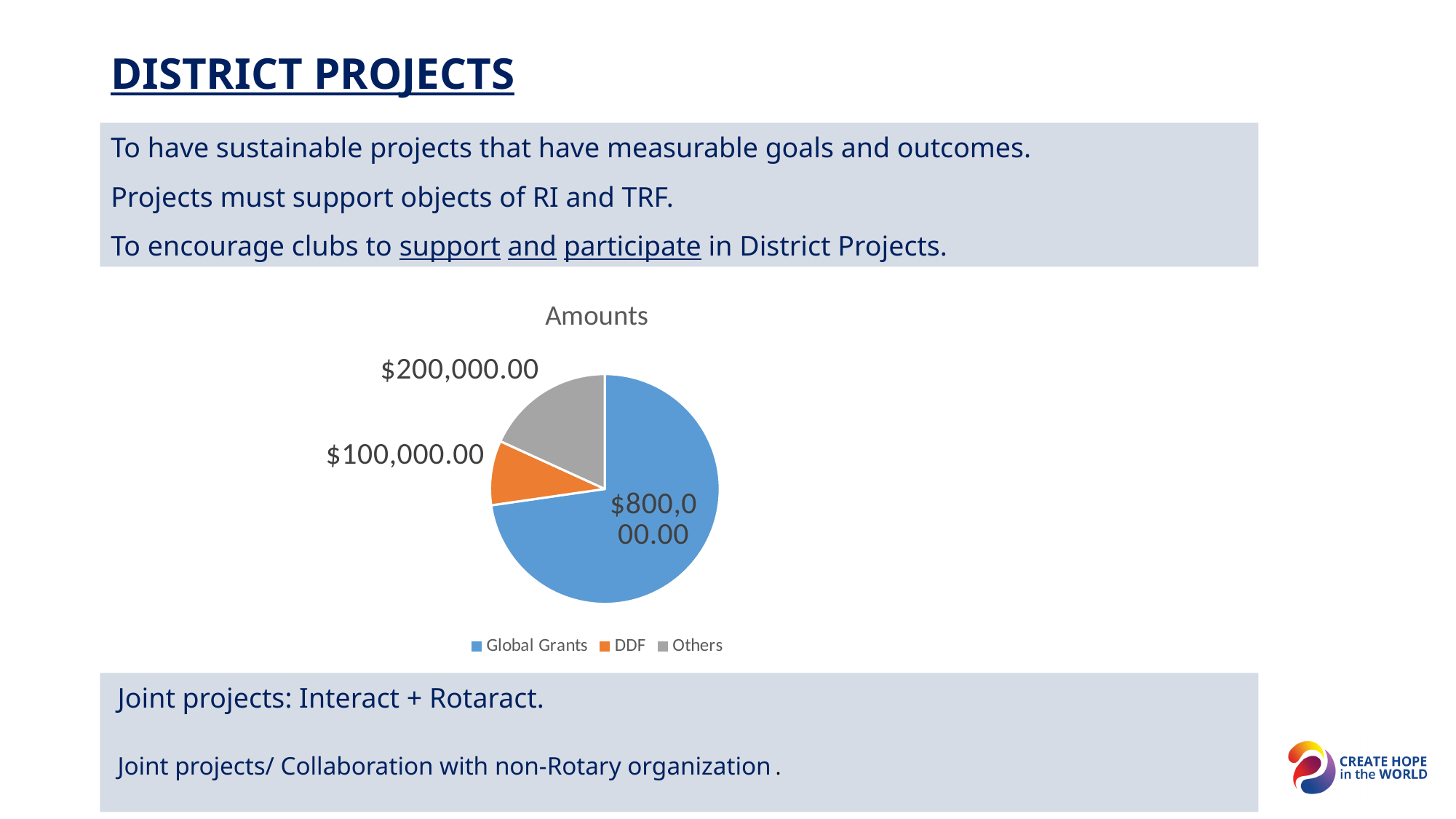
What type of chart is shown on the slide? Pie chart Which is larger, the value for Others or the value for DDF? Others What is the value for Global Grants? $800,000.00 What is the value for Others? $200,000.00 How many categories does the pie chart show? 3 Which category has the largest slice of the pie? Global Grants Which colour represents DDF in the pie chart? Orange What is the total of all slices in the pie chart? $1,100,000.00 What is the value for DDF? $100,000.00 Which category has the smallest slice of the pie? DDF What is the difference between the Global Grants value and the Others value? $600,000.00 What is the title of the chart? Amounts